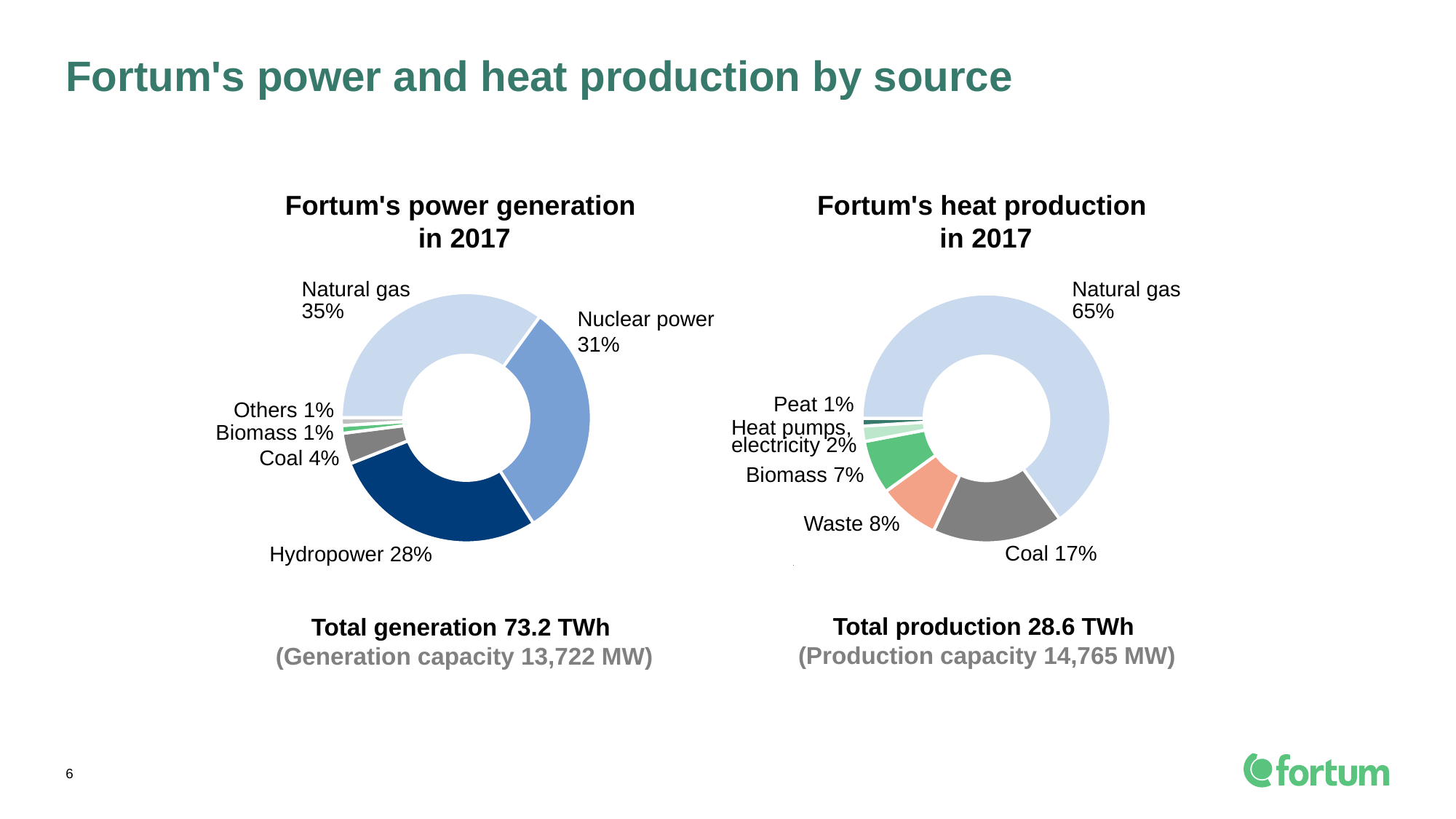
In the 'Fortum's power generation in 2017' chart, which source has the largest share? Natural gas In the 'Fortum's power generation in 2017' chart, what is the difference in percentage points between Nuclear power and Hydropower? 3 percentage points In the 'Fortum's heat production in 2017' chart, what share does Heat pumps, electricity have? 2% How many sources are shown in the 'Fortum's heat production in 2017' chart? 6 In the 'Fortum's heat production in 2017' chart, which is larger, Waste or Biomass? Waste In the 'Fortum's power generation in 2017' chart, what share does Natural gas have? 35% In the 'Fortum's heat production in 2017' chart, what share does Coal have? 17% What total generation is stated below the 'Fortum's power generation in 2017' chart? 73.2 TWh In the 'Fortum's heat production in 2017' chart, which source has the smallest share? Peat How many sources are shown in the 'Fortum's power generation in 2017' chart? 6 What kind of chart is used for 'Fortum's heat production in 2017'? Doughnut (pie) chart In the 'Fortum's power generation in 2017' chart, what is the combined share of Coal, Biomass and Others? 6%